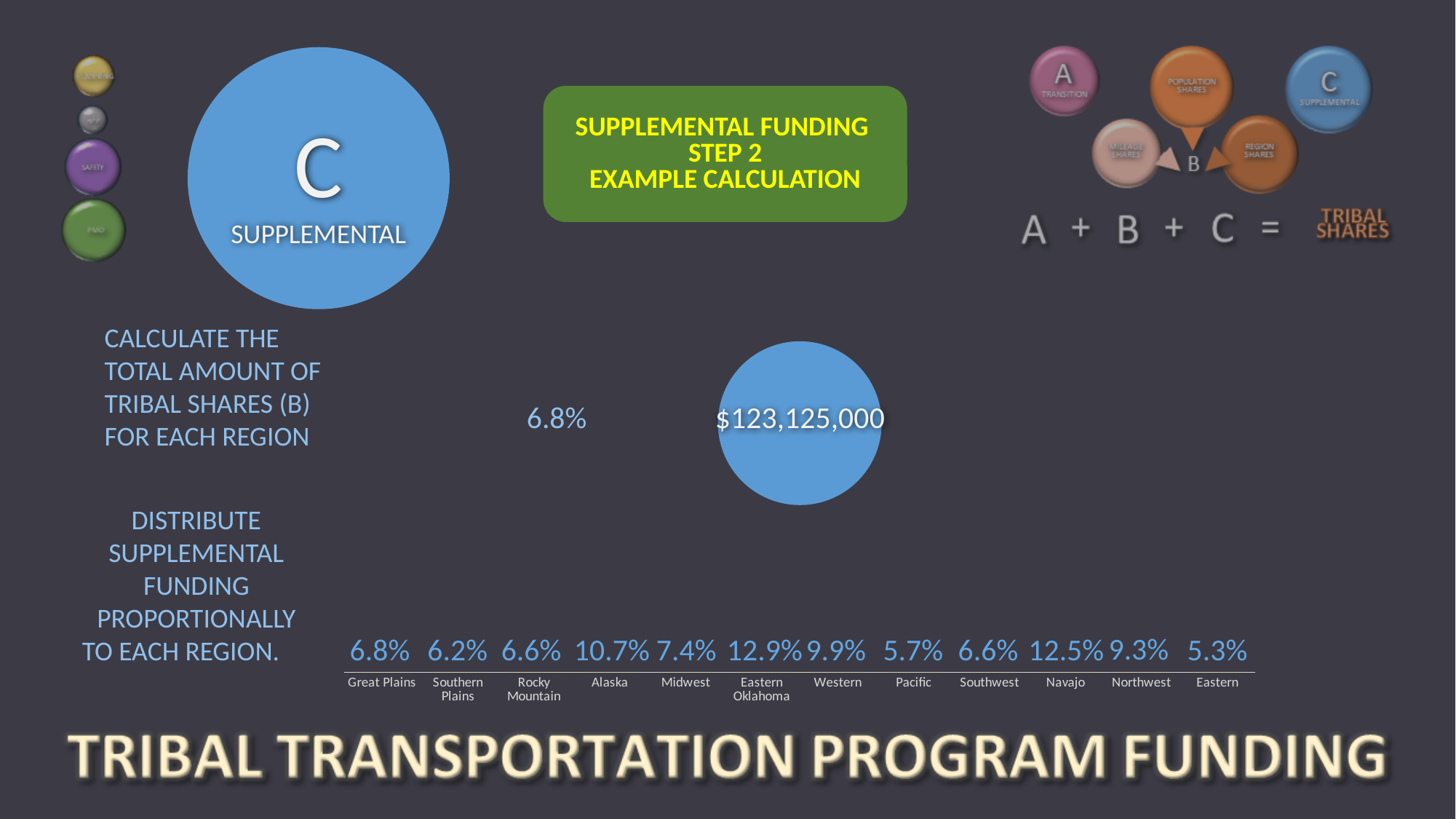
In the bottom chart, what is the value for Navajo? 12.5% In the middle of the slide, what dollar amount is shown in the blue circle next to 6.8%? $123,125,000 In the bottom chart, what is the difference between the values for Eastern Oklahoma and Navajo? 0.4% In the bottom chart, which region has the highest value? Eastern Oklahoma In the bottom chart, what is the value for Pacific? 5.7% In the bottom chart, what is the value for Eastern Oklahoma? 12.9% In the bottom chart, what is the value for Alaska? 10.7% In the bottom chart, what is the value for Northwest? 9.3% In the bottom chart, what is the difference between the values for Alaska and Great Plains? 3.9% How many regions are shown in the bottom chart? 12 In the bottom chart, which region has the lowest value? Eastern In the bottom chart, which is larger, the value for Western or the value for Midwest? Western